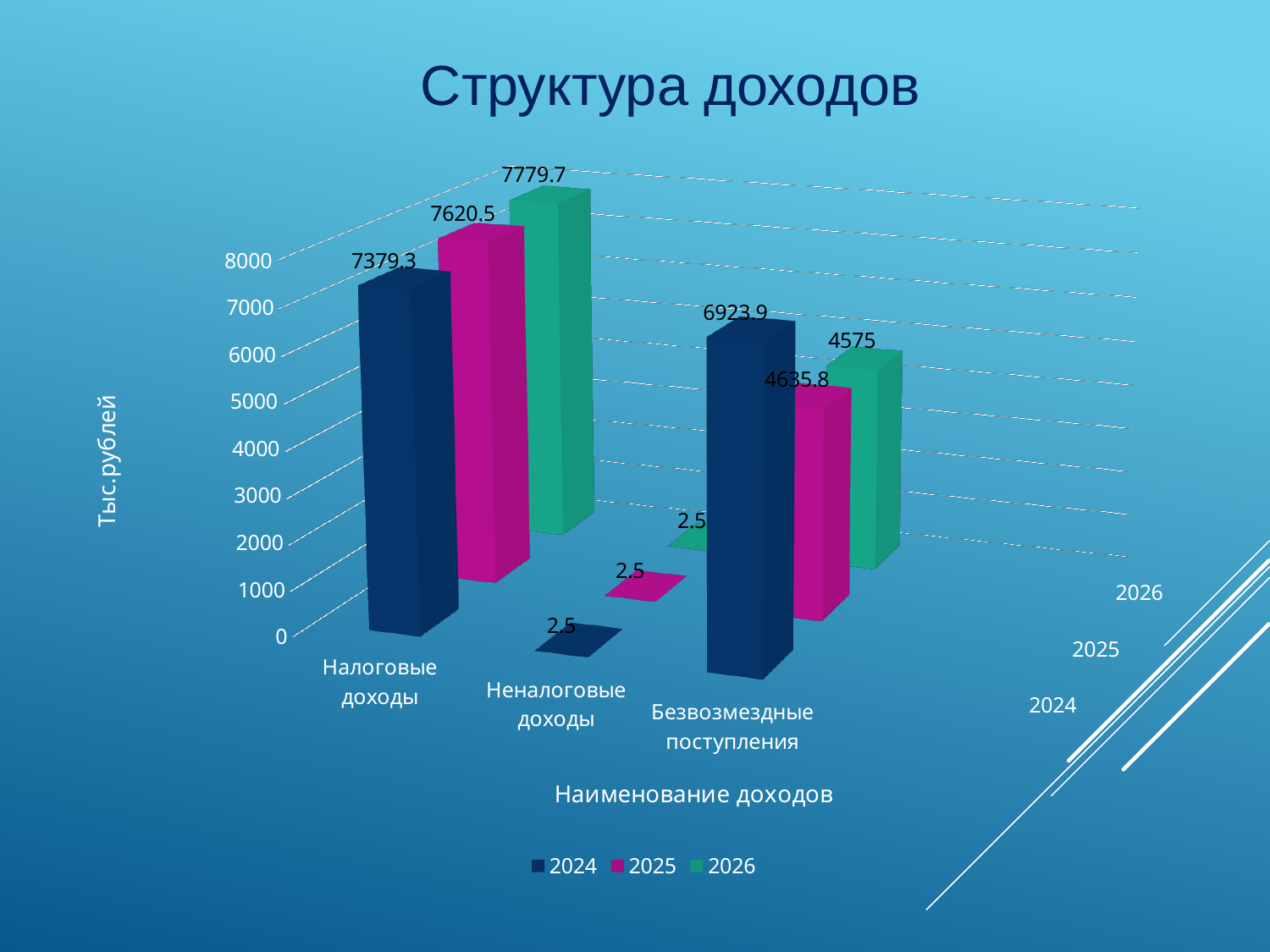
Which is larger for Безвозмездные поступления: the 2024 value or the 2026 value? 2024 What is the value for Безвозмездные поступления in 2025? 4635.8 How many series does the legend list? 3 What is the title of the chart? Структура доходов What is the value for Налоговые доходы in 2026? 7779.7 How many categories are shown on the x axis? 3 What is the difference between the 2026 and 2024 values for Налоговые доходы? 400.4 What is the value for Налоговые доходы in 2024? 7379.3 Which category has the lowest value in 2026? Неналоговые доходы Which category has the highest value in 2024? Налоговые доходы What is the value for Неналоговые доходы in 2025? 2.5 What kind of chart is shown on the slide? Bar chart